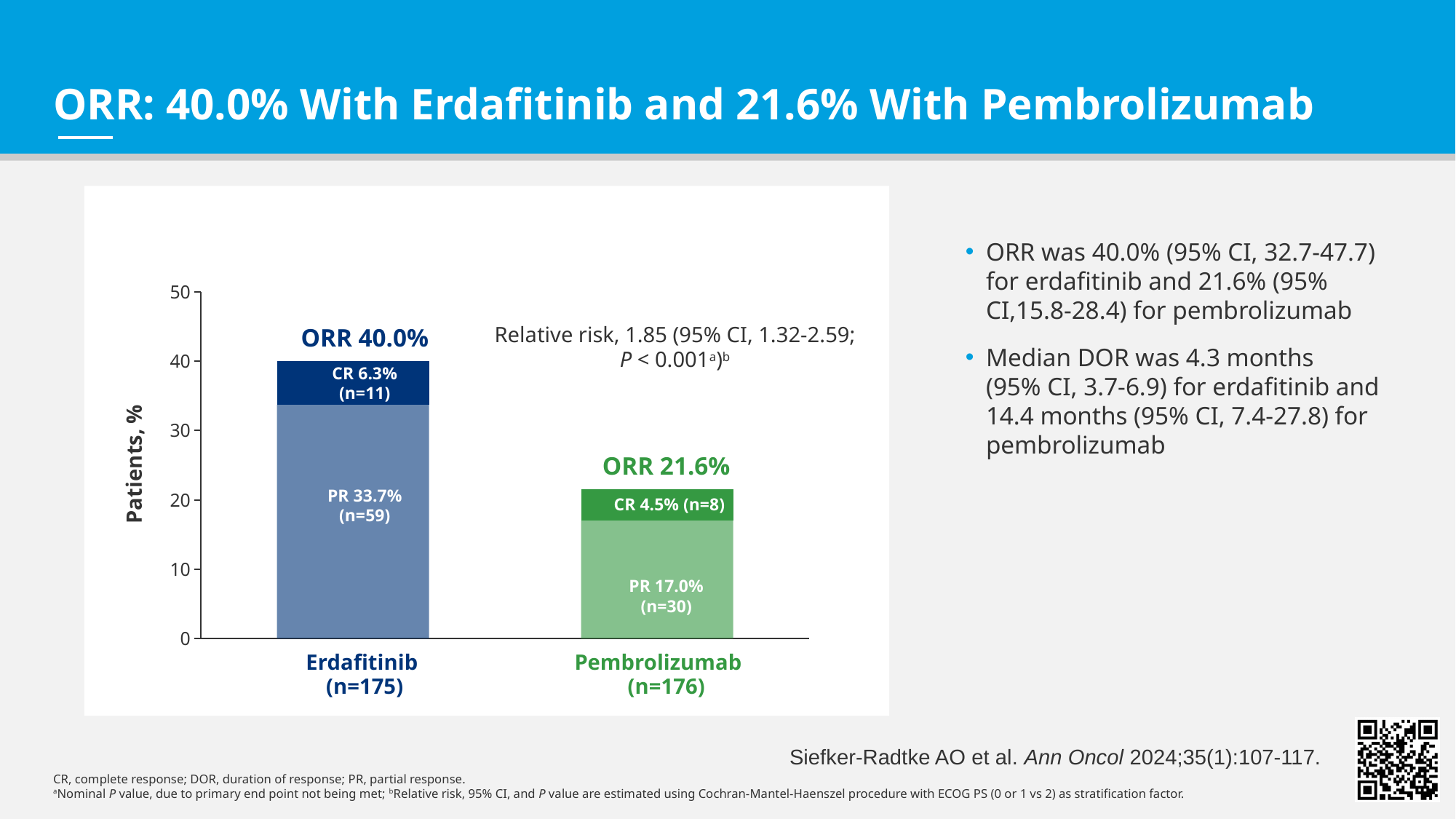
What is the difference in ORR between erdafitinib and pembrolizumab? 18.4% What is the ORR for pembrolizumab? 21.6% What is the label of the y axis? Patients, % Is the CR rate higher for erdafitinib or pembrolizumab? Erdafitinib Is the ORR for pembrolizumab greater or less than 30? less What is the ORR for erdafitinib? 40.0% What is the PR rate for pembrolizumab? 17.0% Which treatment has the higher ORR? Erdafitinib How many patients had a partial response with erdafitinib? 59 What is the CR rate for erdafitinib? 6.3% What type of chart is shown? Stacked bar chart How many treatment groups are shown in the chart? 2